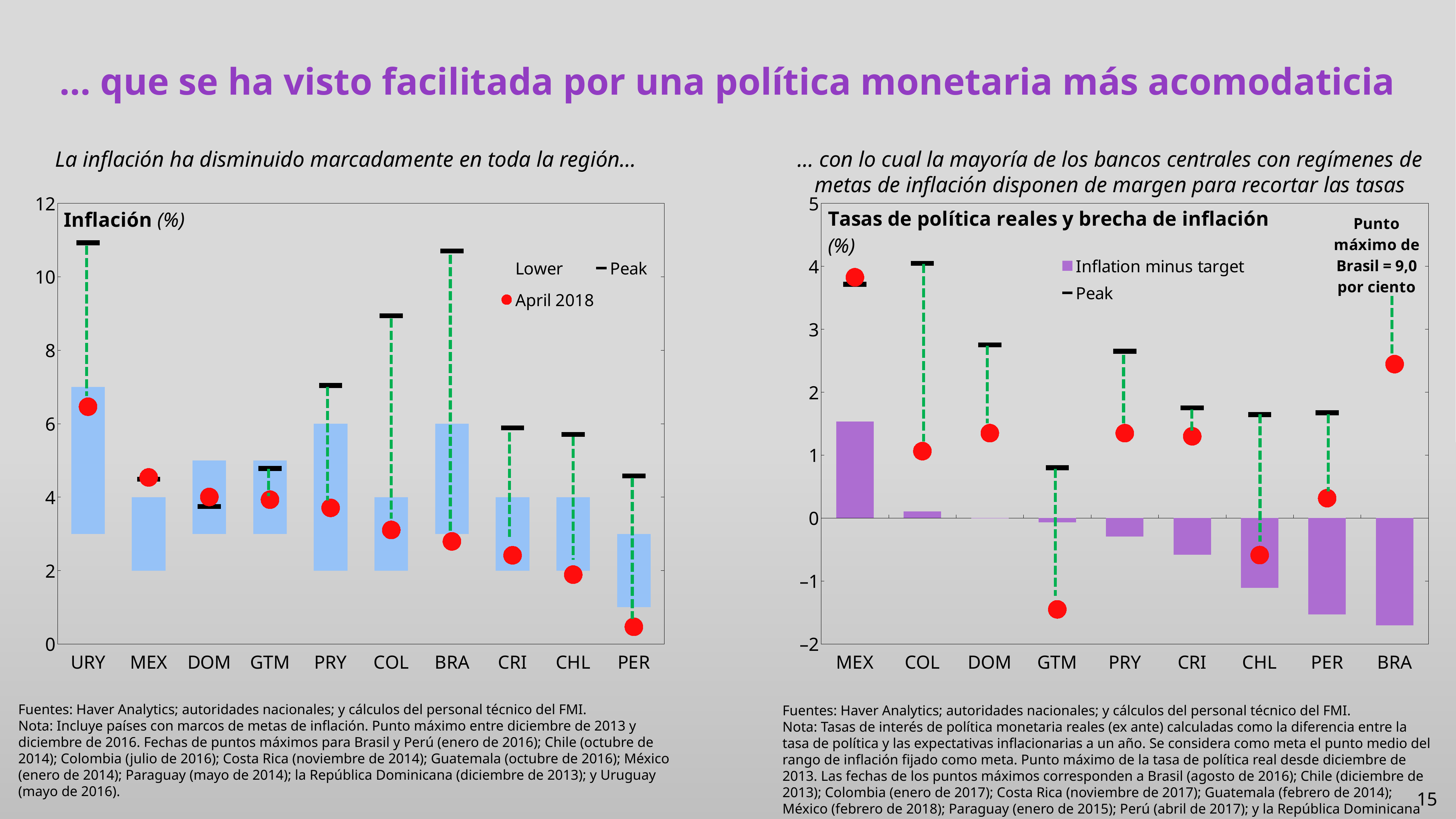
On the left chart (Inflación), which country has the highest April 2018 value? URY On the right chart (Tasas de política reales y brecha de inflación), is the Inflation minus target bar for MEX larger than the one for COL? Yes, MEX On the right chart (Tasas de política reales y brecha de inflación), is the Inflation minus target bar for BRA greater or less than -1? less On the left chart (Inflación), which country has the lowest April 2018 value? PER On the right chart (Tasas de política reales y brecha de inflación), what is the peak value for Brazil according to the annotation? 9,0 por ciento On the left chart (Inflación), is the April 2018 value for URY greater or less than 6? greater On the left chart (Inflación), is the Peak value for BRA greater or less than 10? greater On the left chart (Inflación), how many entries does the legend list? 3 On the left chart (Inflación), how many countries are shown on the x axis? 10 On the right chart (Tasas de política reales y brecha de inflación), which country has the highest Inflation minus target bar? MEX On the right chart (Tasas de política reales y brecha de inflación), how many countries are shown on the x axis? 9 What kind of chart is the right chart (Tasas de política reales y brecha de inflación)? Combination bar and line chart (bars with peak and April 2018 markers)